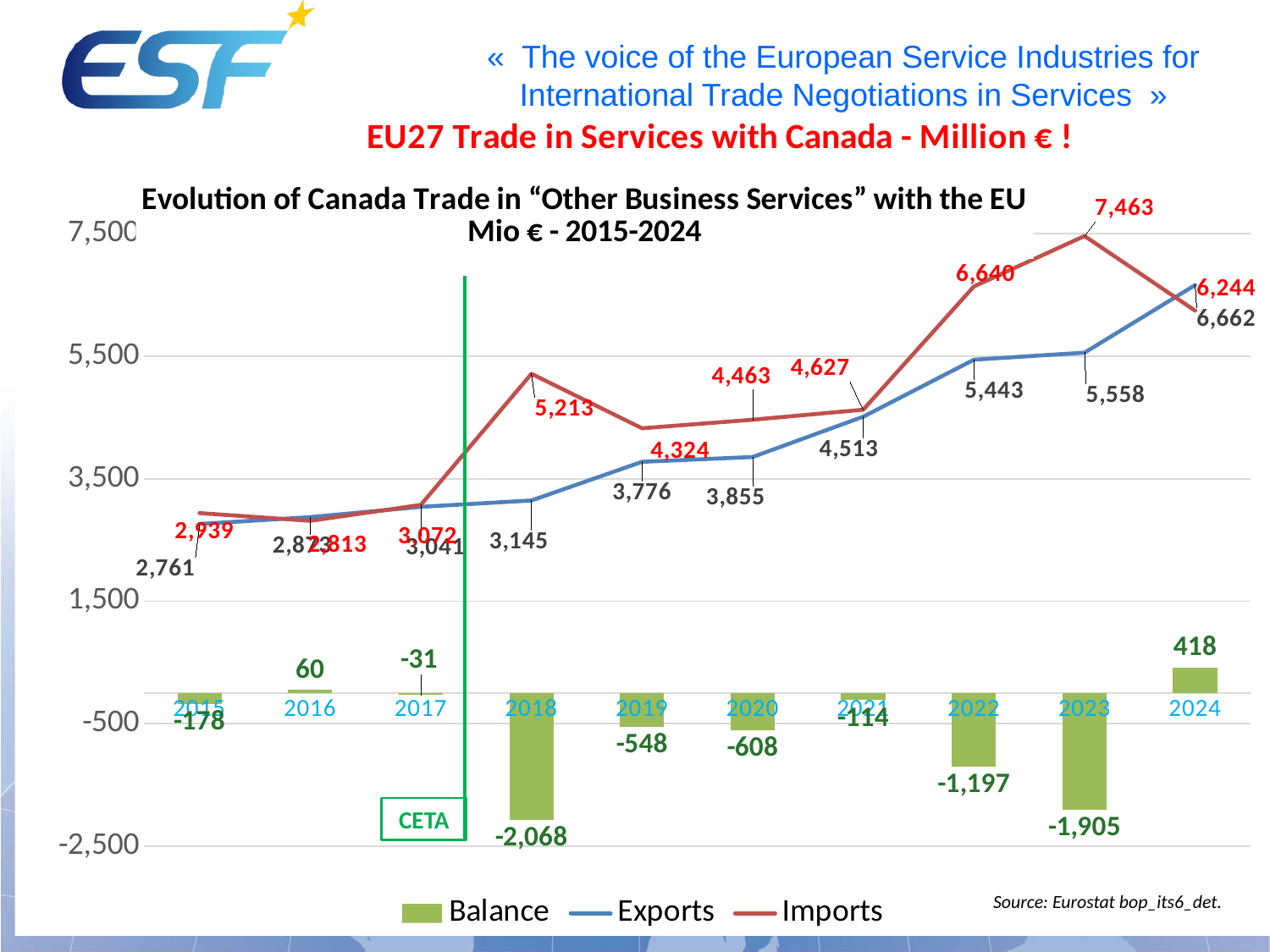
How many series does the legend list? 3 What is the value of Imports in 2023? 7,463 What kind of chart is this? Combined bar and line chart Do Exports rise or fall from 2015 to 2024? rise In 2024, which is larger: Exports or Imports? Exports Is the value for Imports in 2018 greater or less than 5,500? less In which year are Imports highest? 2023 What is the Balance value for 2018? -2,068 What is the value of Exports in 2021? 4,513 In which year is the Balance lowest? 2018 What is the difference between Exports in 2023 and Exports in 2022? 115 How many years are shown on the x axis? 10